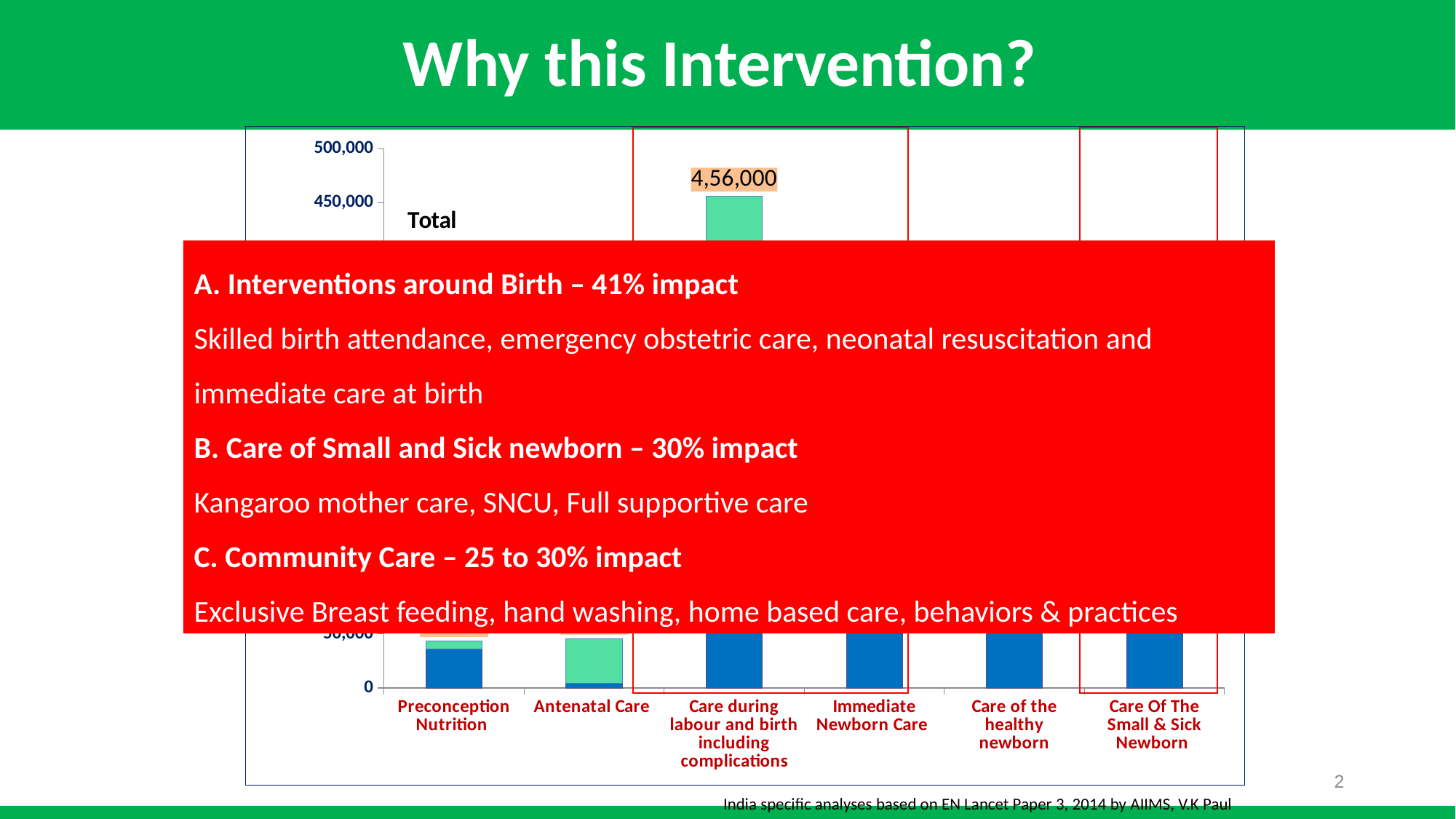
How many categories are labelled along the x axis of the chart? 6 Is the value printed as 4,56,000 on the chart greater or less than 450,000? greater What kind of chart is shown on the slide? bar chart What is the label of the first category on the x axis of the chart? Preconception Nutrition What value is printed as a data label near the top of the chart? 4,56,000 What is the highest value shown on the chart's y axis? 500,000